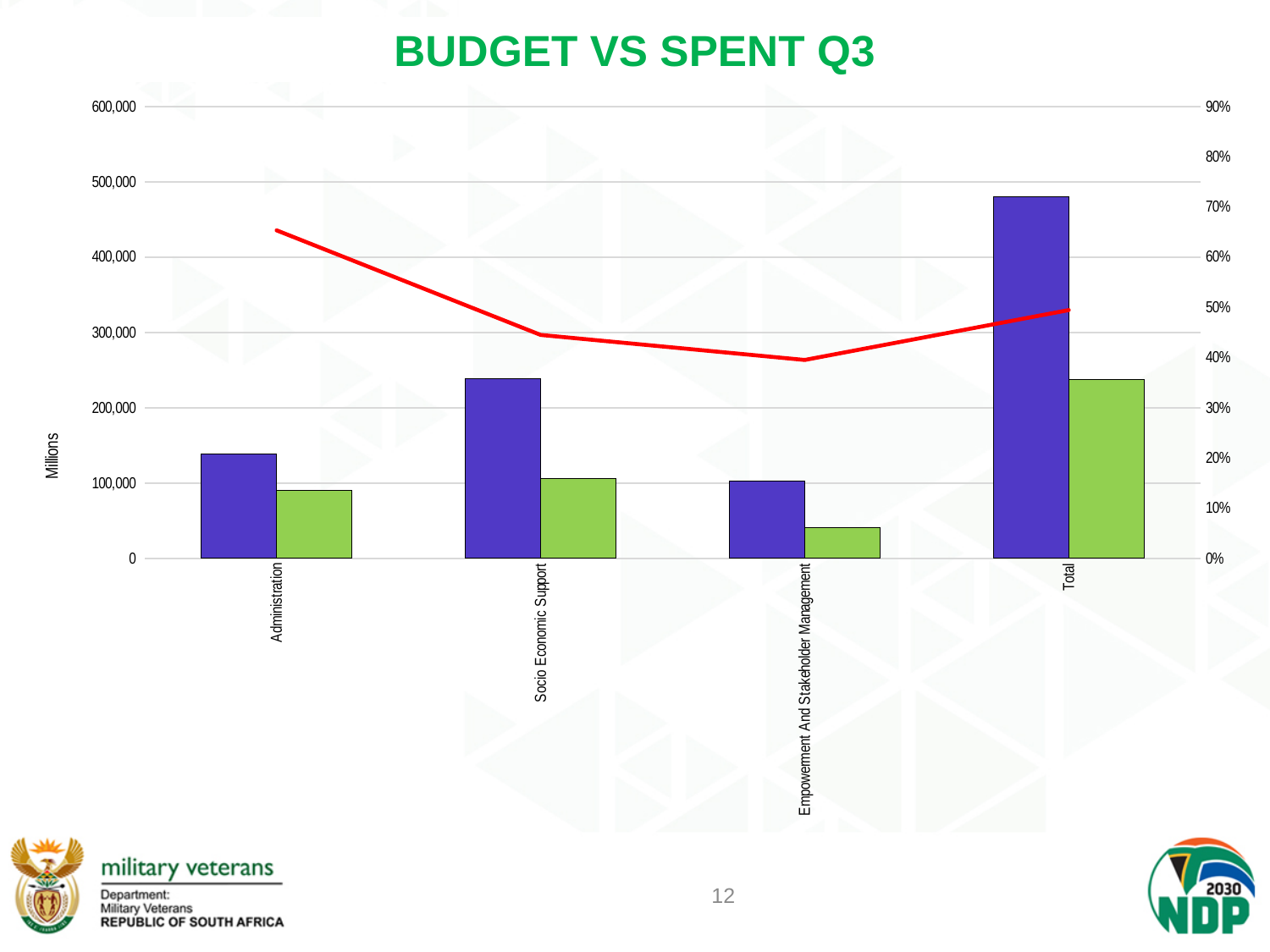
Is the red line value for Empowerment And Stakeholder Management greater or less than 50%? less Is the red line value for Administration greater or less than 60%? greater Is the purple bar for Total greater or less than 400,000? greater What kind of chart is shown on the slide? bar chart with a line Which category has the shortest green bar? Empowerment And Stakeholder Management What is the title of the chart? BUDGET VS SPENT Q3 Which has the taller purple bar, Administration or Empowerment And Stakeholder Management? Administration What is the label on the left vertical axis of the chart? Millions How many categories are shown on the x axis of the chart? 4 Which category has the tallest purple bar? Total